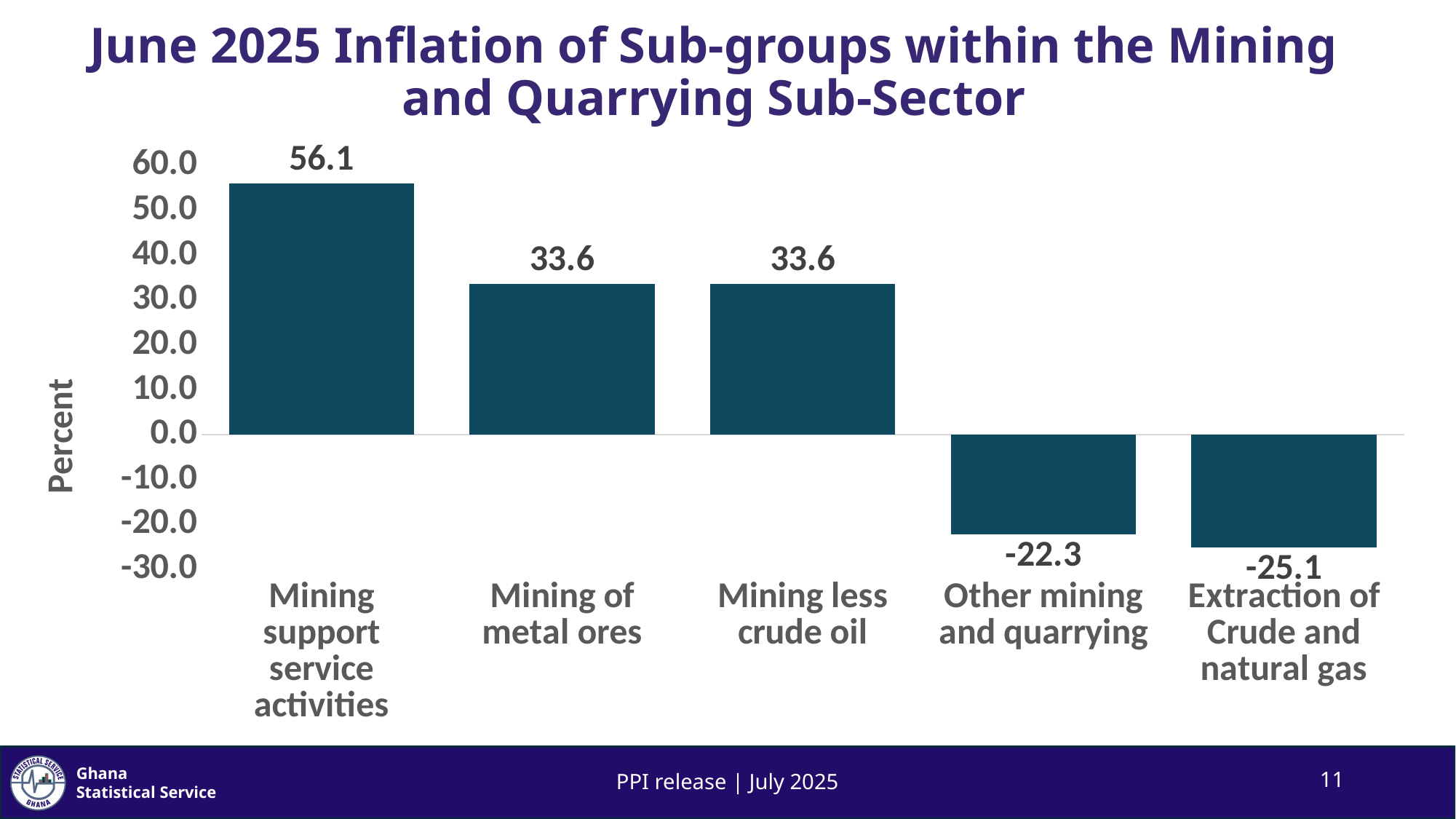
What kind of chart is shown on the slide? Bar chart Which sub-group has the lowest inflation value? Extraction of Crude and natural gas What is the inflation value for Other mining and quarrying? -22.3 Which sub-group has the highest inflation value? Mining support service activities How many sub-groups are shown in the chart? 5 What is the inflation value for Extraction of Crude and natural gas? -25.1 Is the value for Mining support service activities greater or less than 50.0? greater What is the label on the vertical axis of the chart? Percent What is the inflation value for Mining support service activities? 56.1 What is the difference between the inflation values for Mining support service activities and Mining of metal ores? 22.5 Which has a larger inflation value, Mining less crude oil or Other mining and quarrying? Mining less crude oil What is the inflation value for Mining of metal ores? 33.6